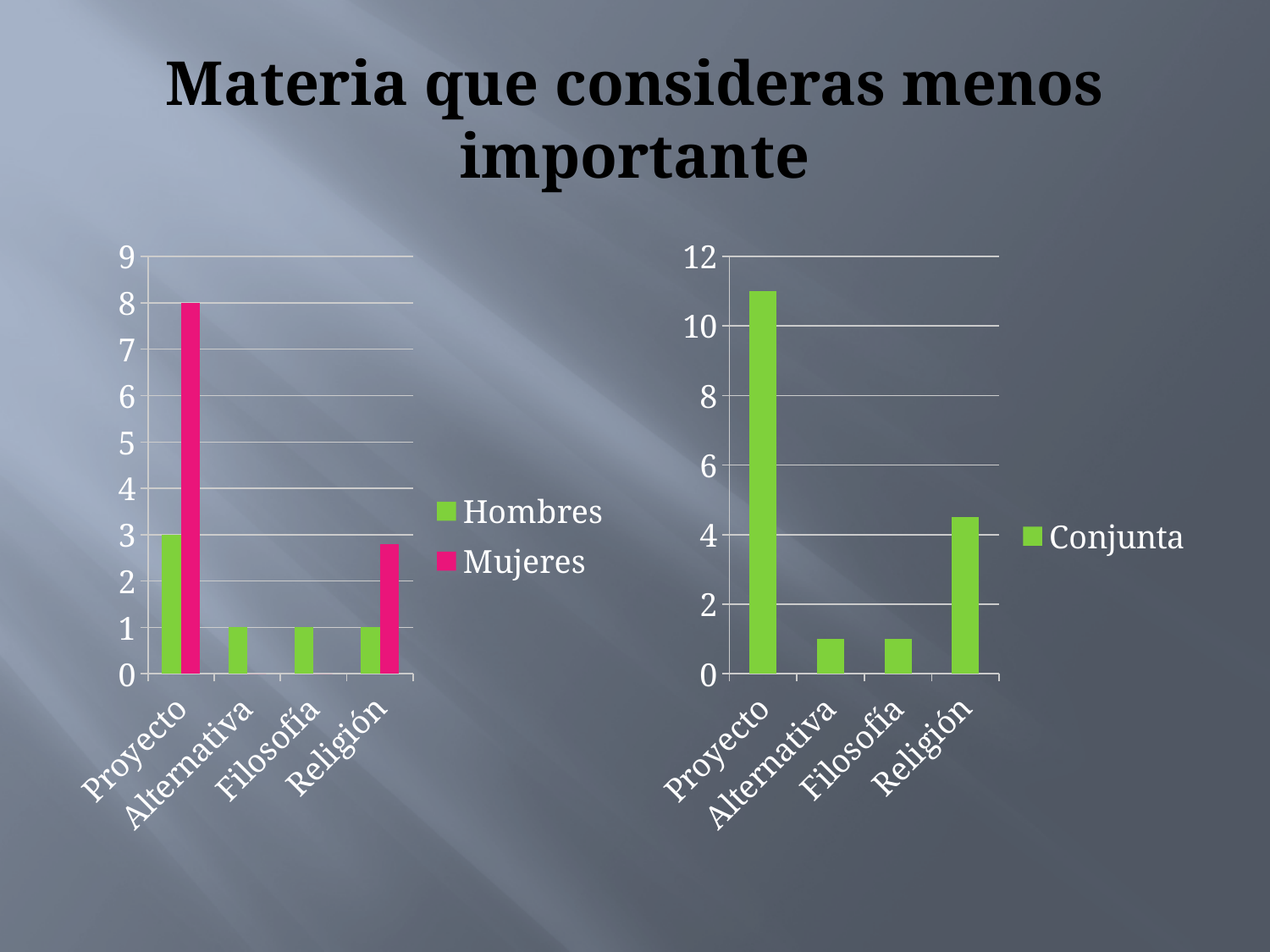
What kind of chart is the right chart? bar chart In the right chart, is the value for Religión greater or less than 4? greater In the right chart, which category has the highest Conjunta value? Proyecto In the left chart, which is larger for Proyecto: Hombres or Mujeres? Mujeres In the right chart, is the value for Alternativa greater or less than 2? less How many categories are shown on the x axis of the right chart? 4 How many series does the legend of the left chart list? 2 In the left chart, what is the difference between the Mujeres and Hombres values for Proyecto? 5 In the left chart, what is the value for Hombres in the Proyecto category? 3 In the left chart, what is the value for Mujeres in the Proyecto category? 8 In the left chart, what is the value for Hombres in the Filosofía category? 1 In the right chart, is the value for Proyecto greater or less than 10? greater